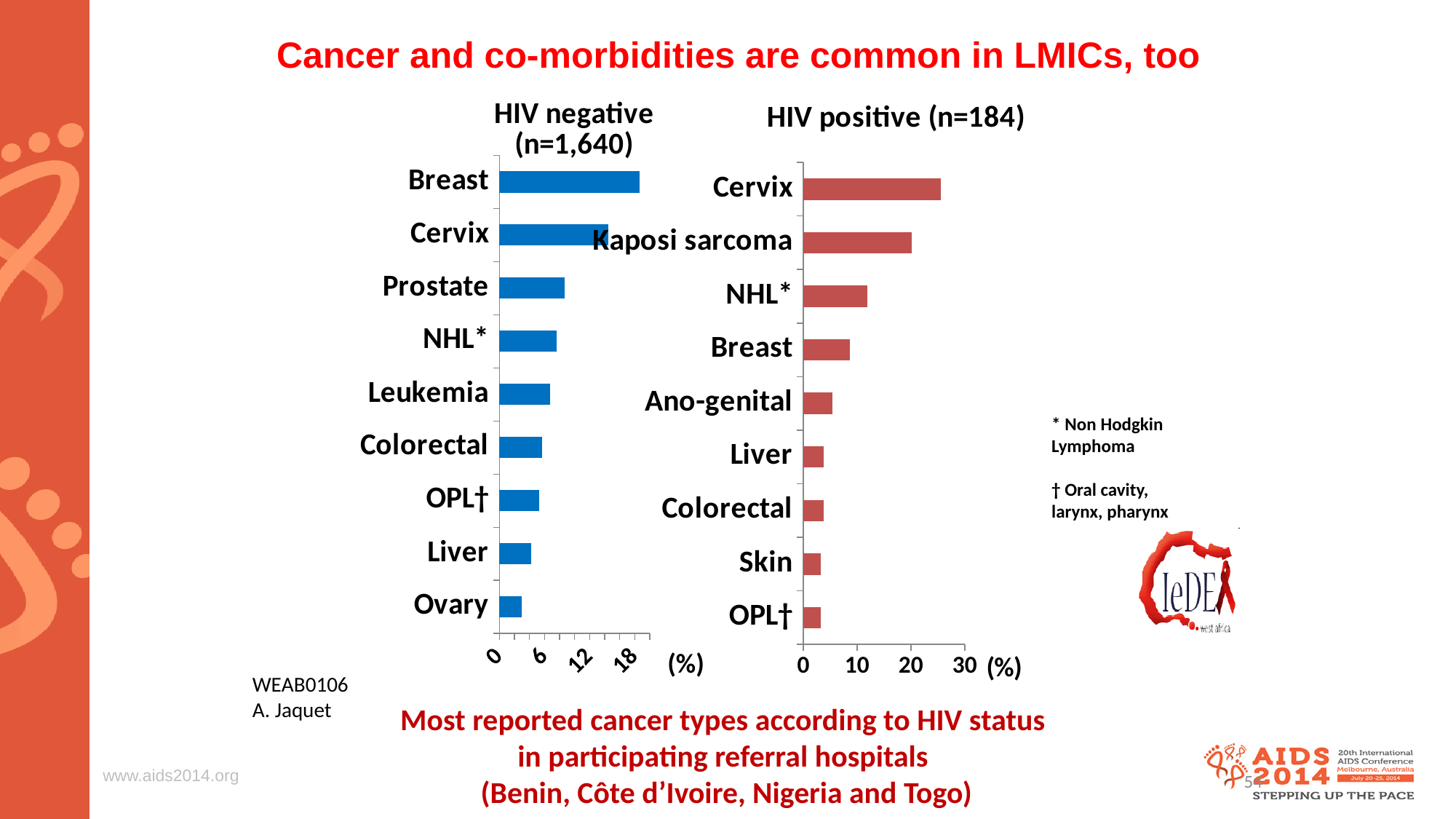
In the HIV negative (n=1,640) chart, what kind of chart is shown? Bar chart In the HIV negative (n=1,640) chart, is the value for Breast greater or less than 18? greater In the HIV positive (n=184) chart, is the value for Cervix greater or less than 20? greater In the HIV negative (n=1,640) chart, how many cancer types are plotted? 9 In the HIV negative (n=1,640) chart, which cancer type has the lowest percentage? Ovary In the HIV positive (n=184) chart, which cancer type has the highest percentage? Cervix What is the sample size shown in the title of the HIV positive chart? n=184 In the HIV negative (n=1,640) chart, which is larger, the value for Cervix or the value for Prostate? Cervix In the HIV positive (n=184) chart, how many cancer types are plotted? 9 In the HIV negative (n=1,640) chart, is the value for Prostate greater or less than 12? less In the HIV negative (n=1,640) chart, which cancer type has the highest percentage? Breast In the HIV positive (n=184) chart, which is larger, the value for Kaposi sarcoma or the value for NHL*? Kaposi sarcoma